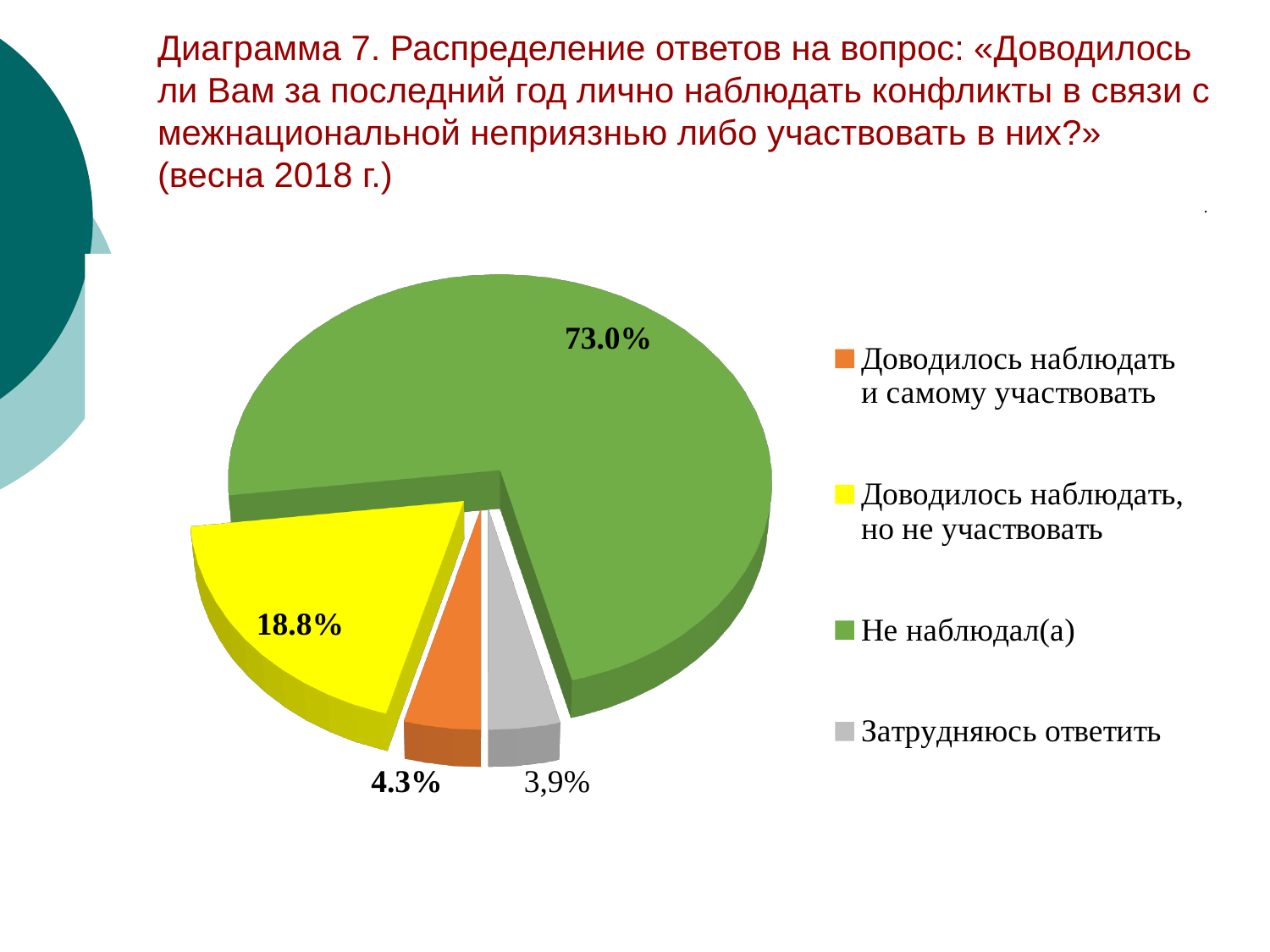
What colour is the slice for «Не наблюдал(а)»? green What share of respondents answered «Затрудняюсь ответить»? 3,9% What share of respondents answered «Доводилось наблюдать и самому участвовать»? 4.3% What is the difference in percentage points between the «Не наблюдал(а)» slice and the «Доводилось наблюдать, но не участвовать» slice? 54.2 What share of respondents answered «Не наблюдал(а)»? 73.0% Which is larger: the share for «Доводилось наблюдать, но не участвовать» or the share for «Доводилось наблюдать и самому участвовать»? Доводилось наблюдать, но не участвовать What type of chart is shown on the slide? pie chart What share of respondents answered «Доводилось наблюдать, но не участвовать»? 18.8% Which answer option has the largest slice of the pie? Не наблюдал(а) How many answer options (slices) does the pie chart show? 4 Which answer option has the smallest slice of the pie? Затрудняюсь ответить How many entries does the legend list? 4